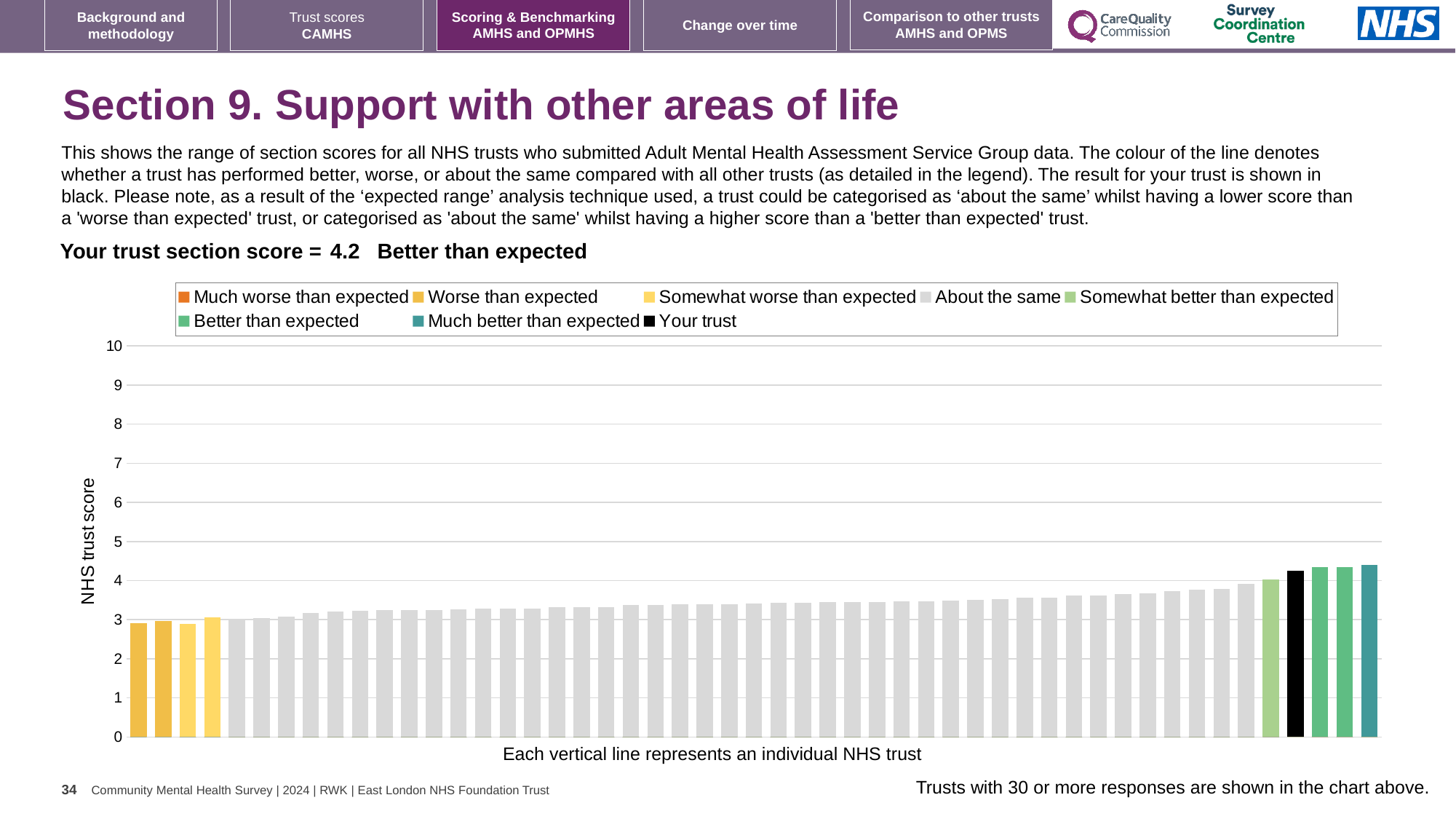
Is the value for your trust's bar greater or less than 4? greater Do the bar values rise or fall from left to right across the chart? Rise How is your trust's section score categorised compared with other trusts? Better than expected Which is larger, the value for your trust's bar or the value for the rightmost (teal) bar? The rightmost (teal) bar Is the value for the tallest bar in the chart greater or less than 5? less What kind of chart is shown on the slide? Bar chart Is the value for the leftmost bar greater or less than 2? greater What is the label on the vertical axis of the chart? NHS trust score How many bars are shown in black (your trust)? 1 According to the chart's x-axis caption, what does each vertical line represent? An individual NHS trust How many entries does the chart legend list? 8 What is the section score for your trust? 4.2